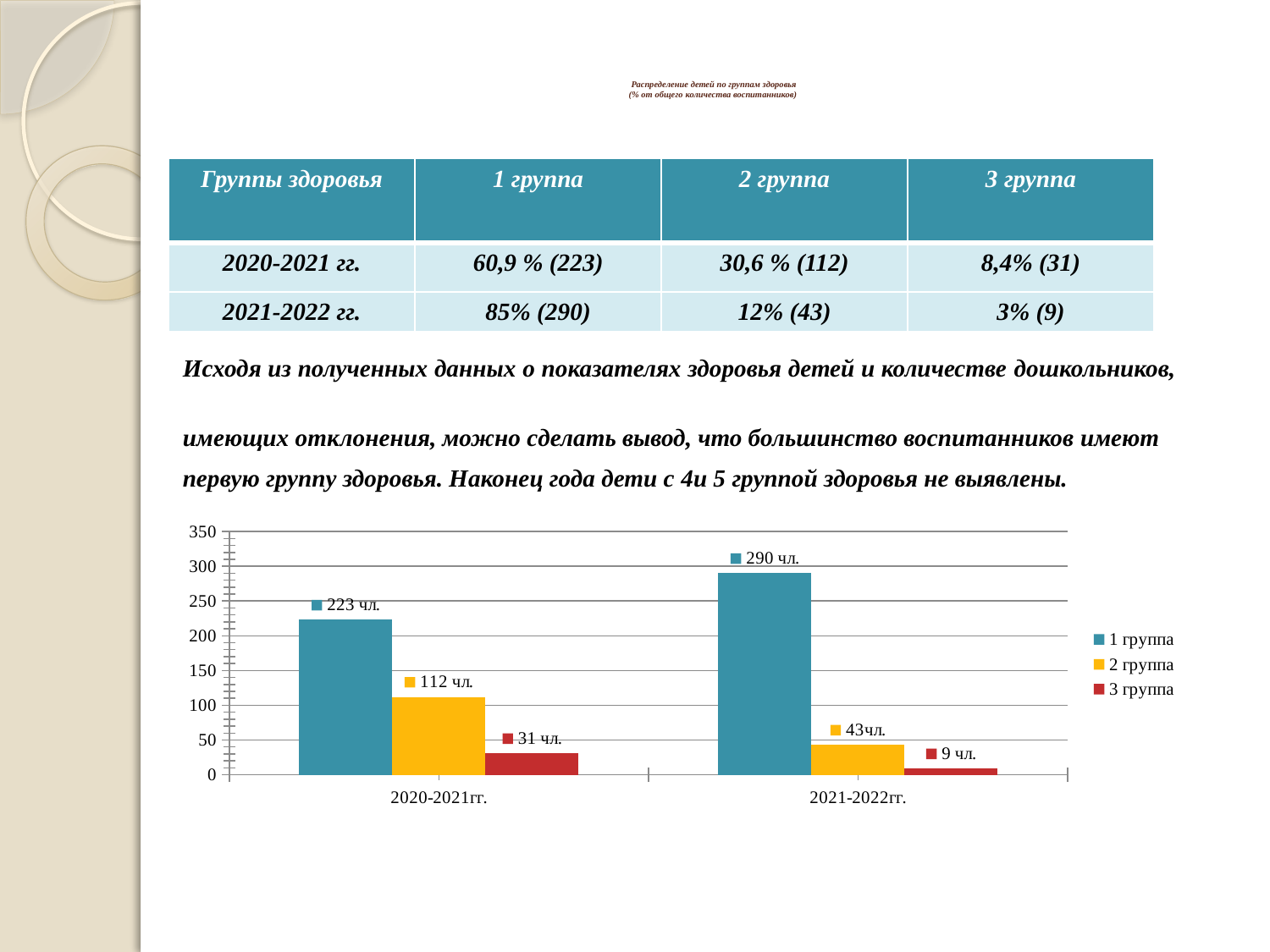
How many categories are shown on the x axis of the chart? 2 Does the value for 1 группа rise or fall from 2020-2021гг. to 2021-2022гг.? rise Which series has the highest value in 2021-2022гг.? 1 группа Which series has the lowest value in 2020-2021гг.? 3 группа What is the value for 3 группа in 2021-2022гг.? 9 чл. Which is larger: 2 группа in 2020-2021гг. or 2 группа in 2021-2022гг.? 2 группа in 2020-2021гг. What kind of chart is shown on the slide? bar chart What is the value for 1 группа in 2020-2021гг.? 223 чл. What is the difference between the 1 группа values for 2021-2022гг. and 2020-2021гг.? 67 How many series does the chart legend list? 3 What is the value for 1 группа in 2021-2022гг.? 290 чл. What is the value for 2 группа in 2020-2021гг.? 112 чл.